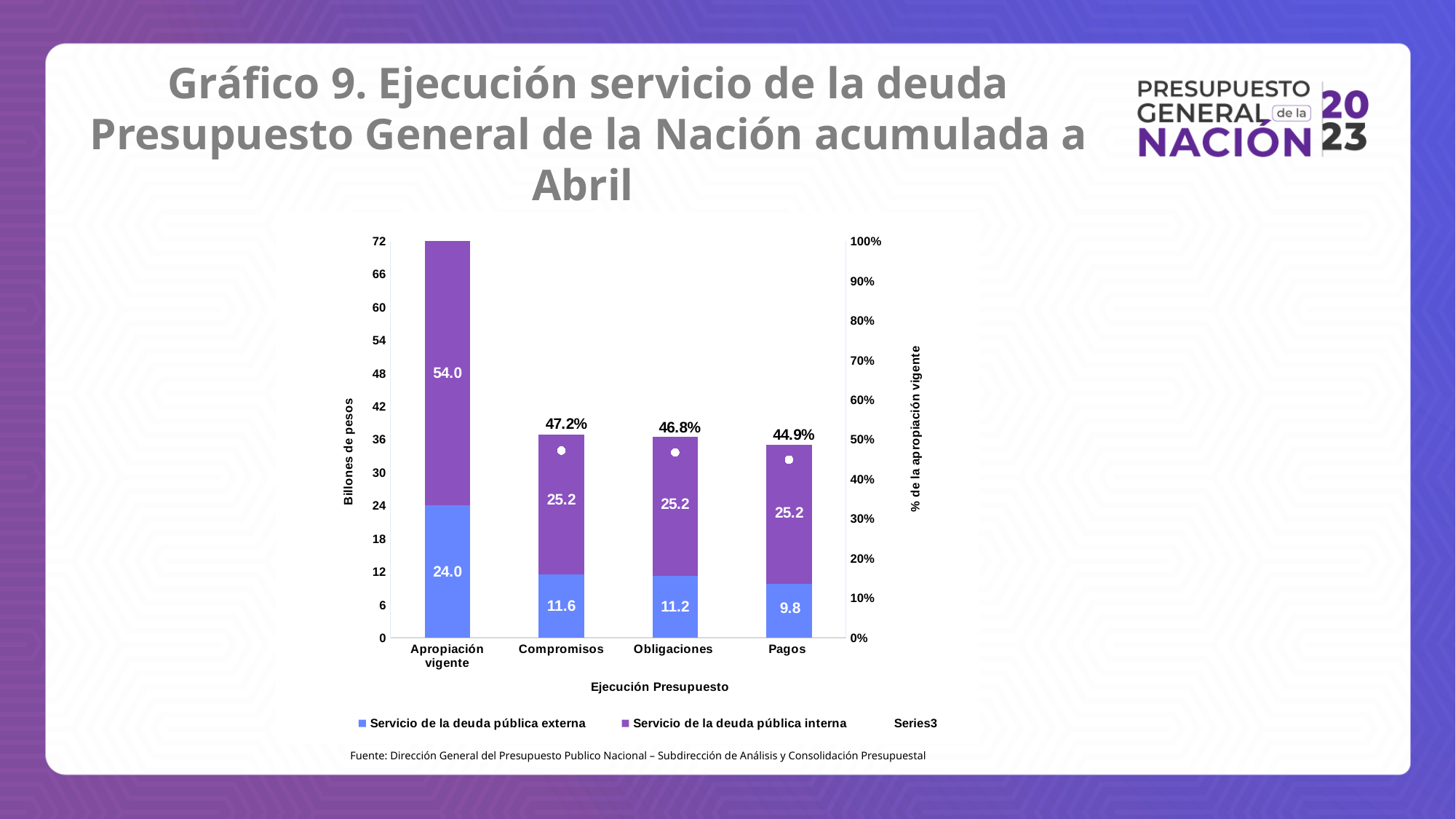
Do the percentage values fall or rise from Compromisos to Pagos? fall What percentage of the apropiación vigente is shown for Compromisos? 47.2% Which has a higher percentage of the apropiación vigente, Compromisos or Obligaciones? Compromisos What percentage of the apropiación vigente is shown for Pagos? 44.9% What is the value of Servicio de la deuda pública interna for Apropiación vigente? 54.0 How many categories are shown on the x axis? 4 Which category has the lowest value for Servicio de la deuda pública externa? Pagos What is the total of the stacked bar for Compromisos? 36.8 What is the value of Servicio de la deuda pública externa for Apropiación vigente? 24.0 How many series does the legend list? 3 What is the value of Servicio de la deuda pública externa for Pagos? 9.8 What is the difference between the Servicio de la deuda pública externa values for Compromisos and Obligaciones? 0.4